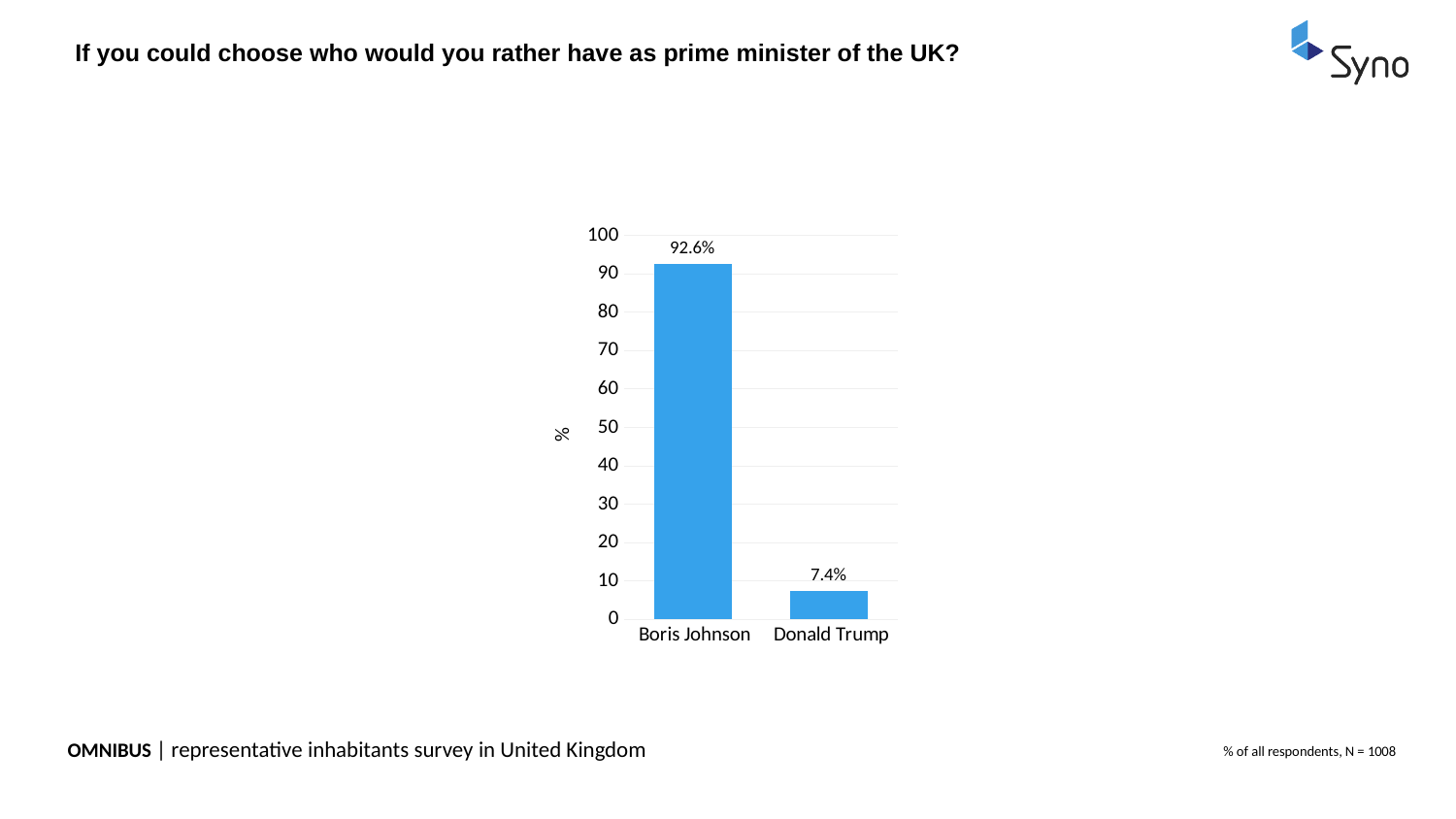
Which category has the highest value? Boris Johnson What percentage of respondents chose Boris Johnson? 92.6% Is the value for Boris Johnson greater or less than 90? greater Is the value for Donald Trump greater or less than 10? less What percentage of respondents chose Donald Trump? 7.4% What is the label on the vertical axis of the chart? % What kind of chart is shown on the slide? bar chart How many categories are shown in the chart? 2 Which is larger, the value for Boris Johnson or the value for Donald Trump? Boris Johnson Which category has the lowest value? Donald Trump What is the maximum value shown on the vertical axis? 100 What is the difference between the values for Boris Johnson and Donald Trump? 85.2%